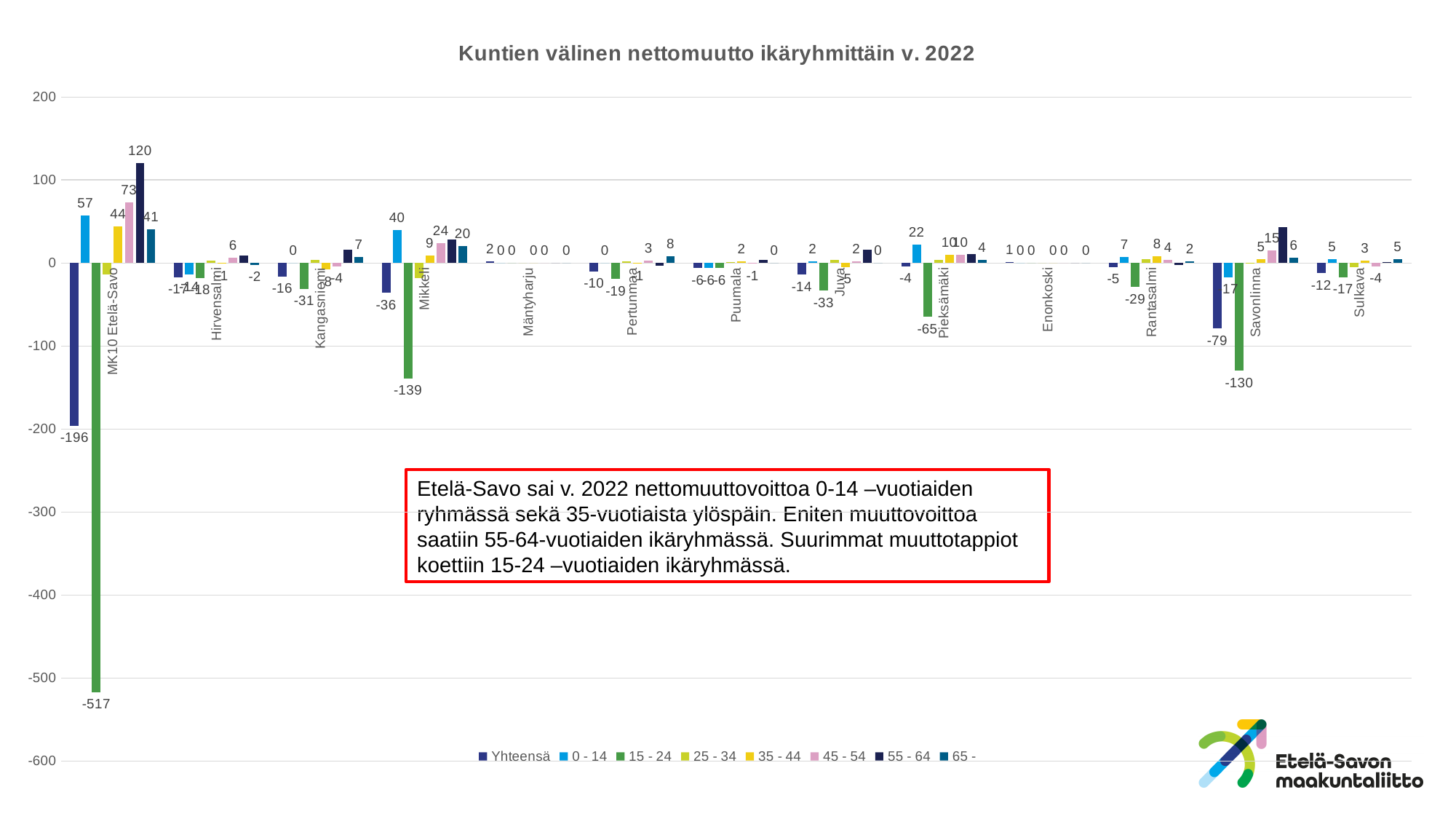
What is the Yhteensä value for MK10 Etelä-Savo? -196 How many municipalities/categories are shown on the x axis? 13 Which is lower, the 15 - 24 value for Mikkeli or the 15 - 24 value for Savonlinna? Mikkeli How many series does the legend list? 8 What is the Yhteensä value for Savonlinna? -79 What is the difference between the 55 - 64 value (120) and the 0 - 14 value (57) for MK10 Etelä-Savo? 63 Which age group has the highest value for MK10 Etelä-Savo? 55 - 64 What is the value for the 55 - 64 age group for MK10 Etelä-Savo? 120 What is the value for the 15 - 24 age group for MK10 Etelä-Savo? -517 Which age group has the lowest value for MK10 Etelä-Savo? 15 - 24 What is the value for the 15 - 24 age group for Mikkeli? -139 What kind of chart is shown on the slide? bar chart